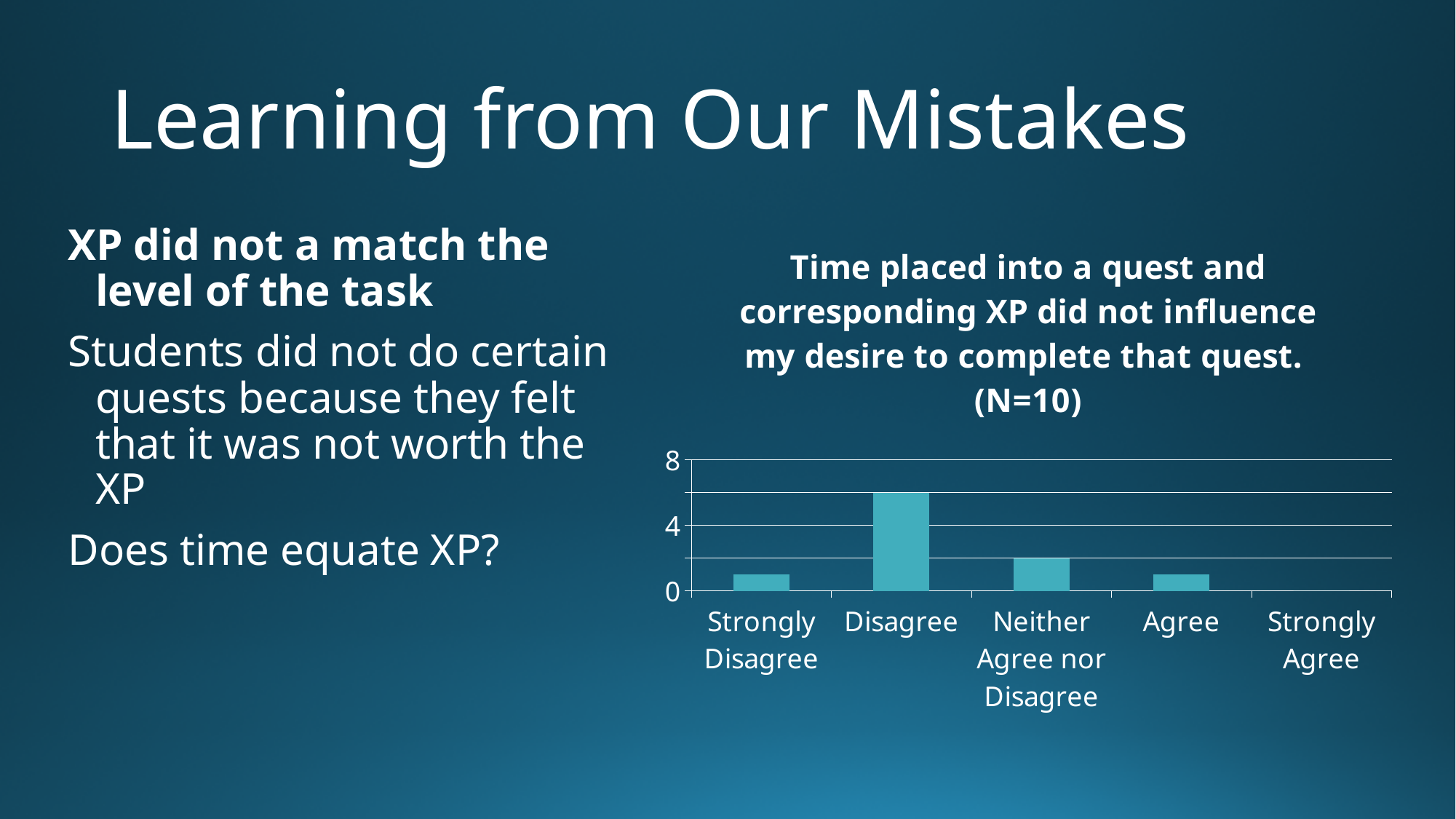
Which response category has the highest bar in the chart? Disagree Is the value for Neither Agree nor Disagree greater or less than 4? less How many response categories are shown on the x axis of the chart? 5 What kind of chart is shown on the slide? bar chart What is the highest value labelled on the vertical axis of the chart? 8 Is the value for Agree greater or less than 4? less Which response category has the lowest value in the chart? Strongly Agree Is the value for Disagree greater or less than 4? greater Which is larger in the chart, the value for Disagree or the value for Neither Agree nor Disagree? Disagree What sample size (N) is stated in the chart title? N=10 What is the value for Strongly Agree in the chart? 0